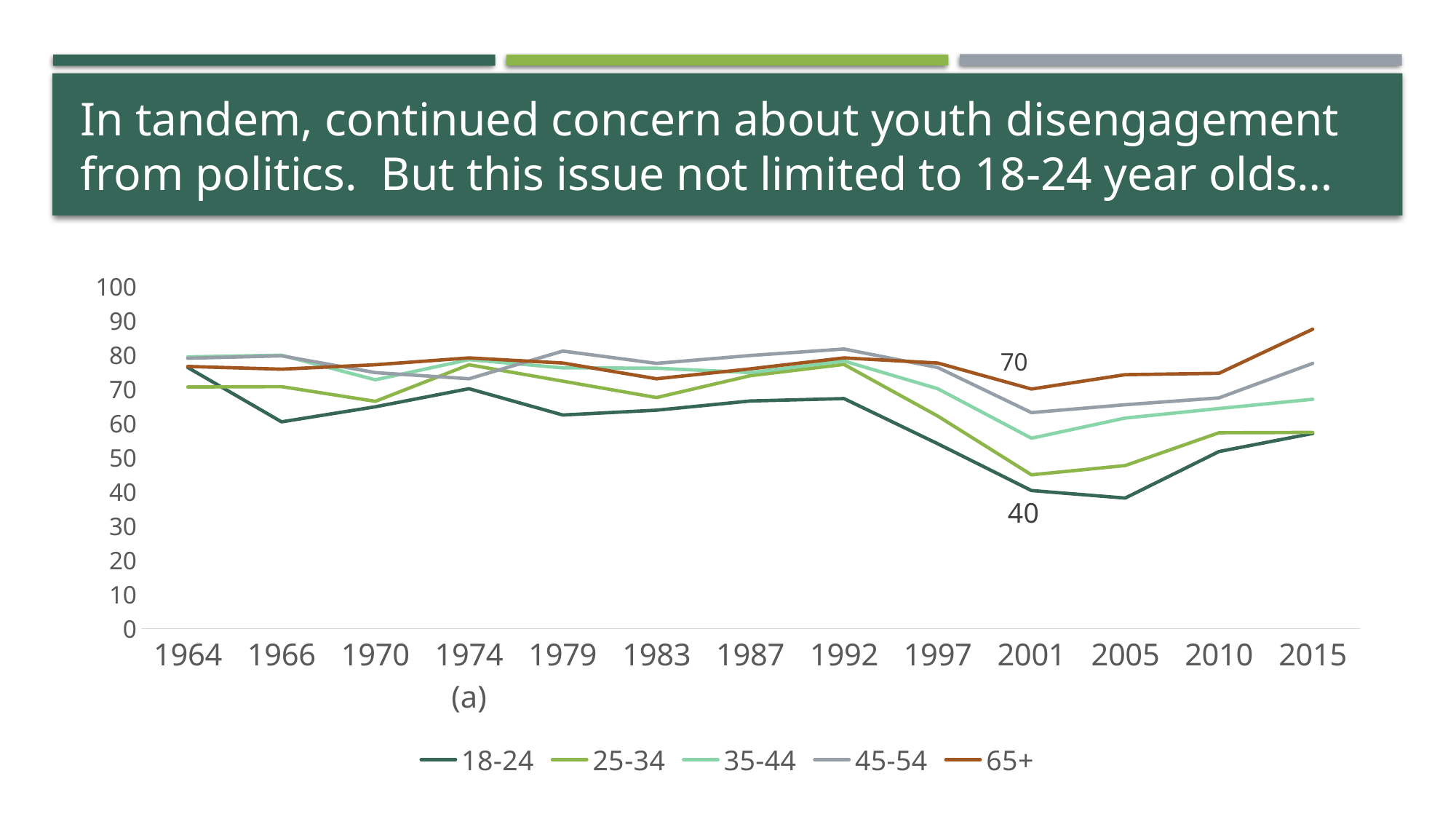
What is the labelled value for the 18-24 series in 2001? 40 In 2001, which is larger: the 65+ value or the 18-24 value? 65+ Which series has the highest value in 2015? 65+ What is the labelled value for the 65+ series in 2001? 70 How many years are shown along the x axis? 13 Is the value for 18-24 in 1966 greater or less than 70? less What kind of chart is shown on the slide? line chart How many series does the legend list? 5 Is the value for 65+ in 2015 greater or less than 80? greater What is the difference between the labelled 65+ value and the labelled 18-24 value in 2001? 30 Which series has the lowest value in 2005? 18-24 Does the 18-24 series rise or fall between 1992 and 2005? fall